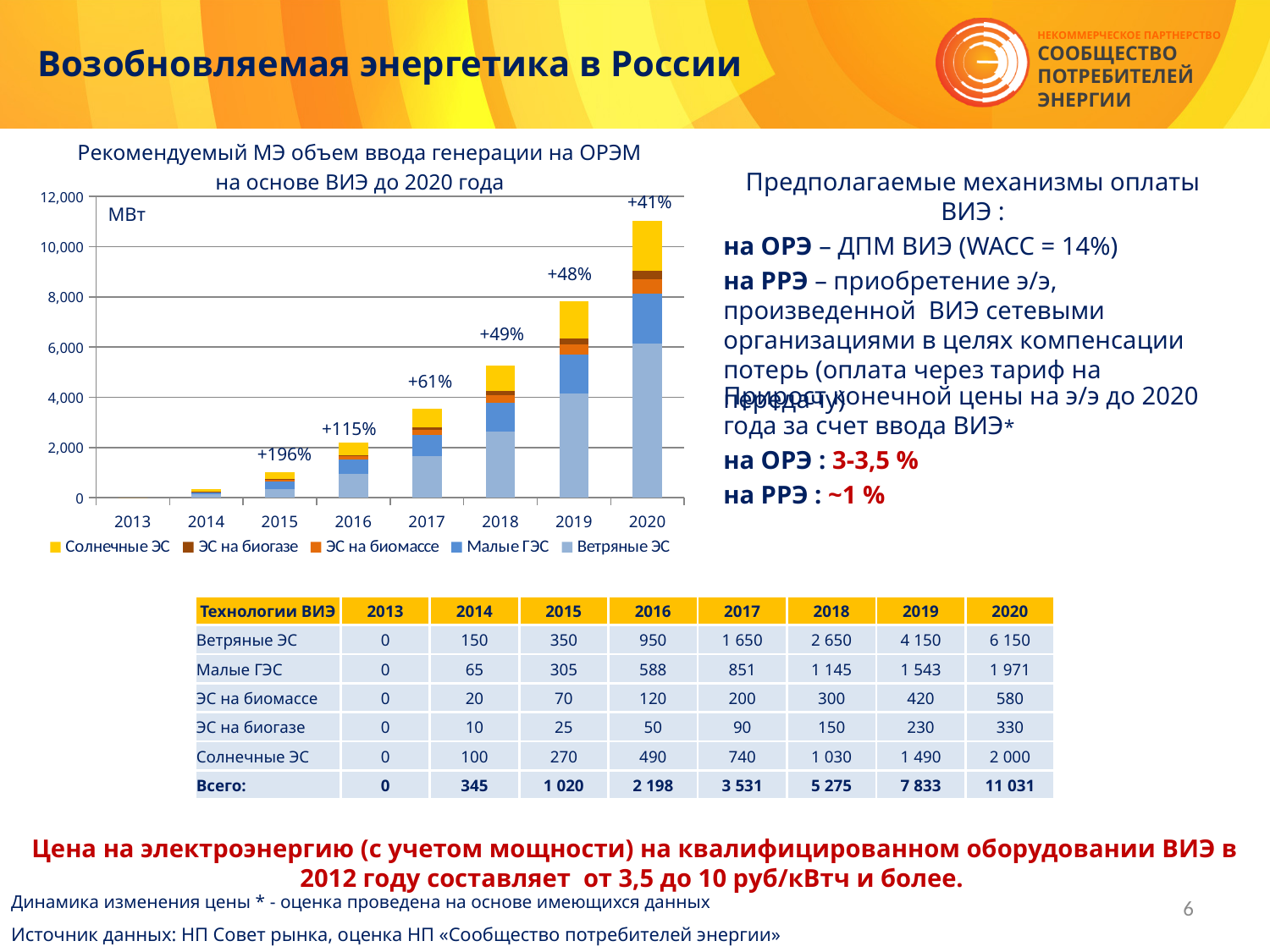
How many series does the legend of the bar chart list? 5 Do the stacked bar totals rise or fall from 2013 to 2020? Rise Is the total height of the 2018 bar greater or less than 6,000? less What growth percentage is labelled above the 2020 bar in the chart? +41% How many years are shown on the x axis of the bar chart? 8 What type of chart is used to show the recommended volume of renewable generation commissioning up to 2020? Stacked bar chart Is the total height of the 2020 bar greater or less than 10,000? greater Which year has the tallest stacked bar in the chart? 2020 What unit is shown in the top-left corner of the chart's plot area? МВт According to the table below the chart, what is the total (Всего) for 2020? 11 031 What growth percentage is labelled above the 2015 bar in the chart? +196% What growth percentage is labelled above the 2016 bar in the chart? +115%